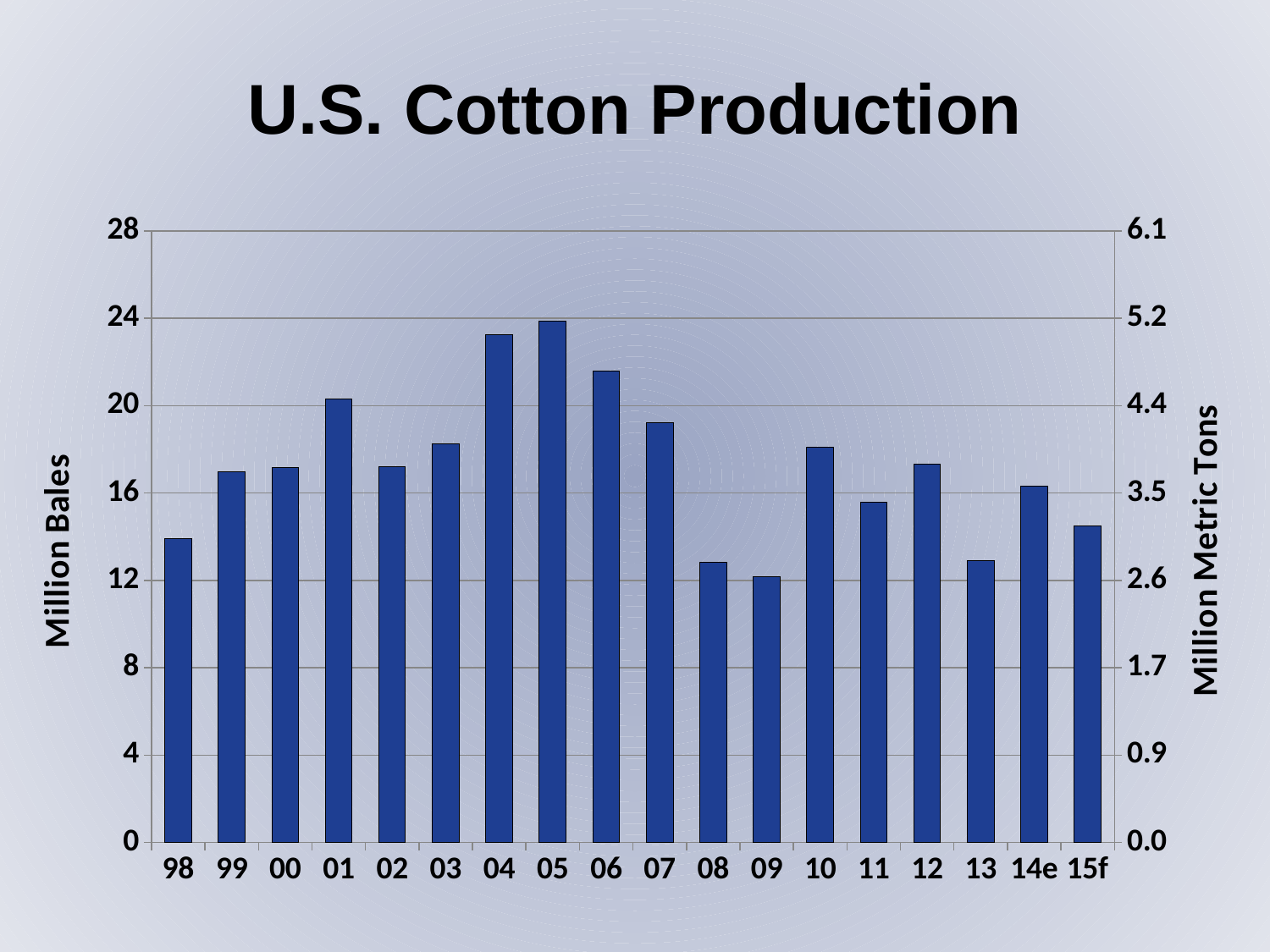
How many years (categories) are plotted on the x axis? 18 Which year has the lowest U.S. cotton production? 09 Which year has the larger production, 04 or 07? 04 What kind of chart is shown on the slide? bar chart Which year has the larger production, 10 or 11? 10 Is the value for 98 greater or less than 16 million bales? less What is the title of the chart? U.S. Cotton Production Is the value for 15f greater or less than 16 million bales? less Which year has the highest U.S. cotton production? 05 Is the value for 06 greater or less than 20 million bales? greater Do the values rise or fall from 05 to 09? fall